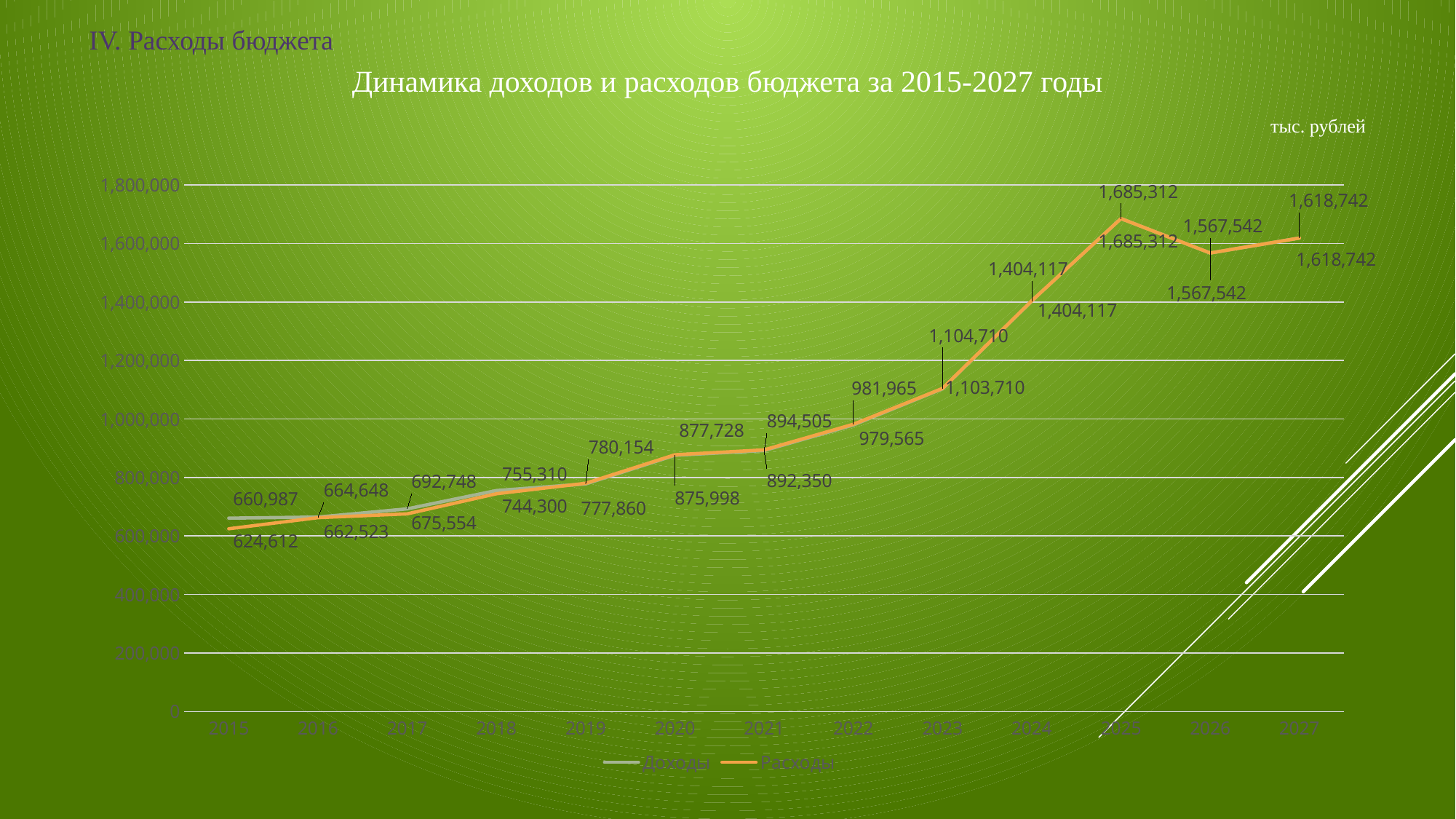
What is the value of Доходы in 2020? 875,998 What is the difference between Доходы and Расходы in 2015? 36,375 How many years are plotted along the x axis? 13 What kind of chart is shown on the slide? line chart What is the value of Расходы in 2023? 1,104,710 What is the value of Расходы in 2015? 624,612 How many series does the legend list? 2 In which year is Доходы lowest? 2015 What is the title of the chart? Динамика доходов и расходов бюджета за 2015-2027 годы Which is larger in 2018, Доходы or Расходы? Доходы In which year is Расходы highest? 2025 What is the value of Доходы in 2015? 660,987